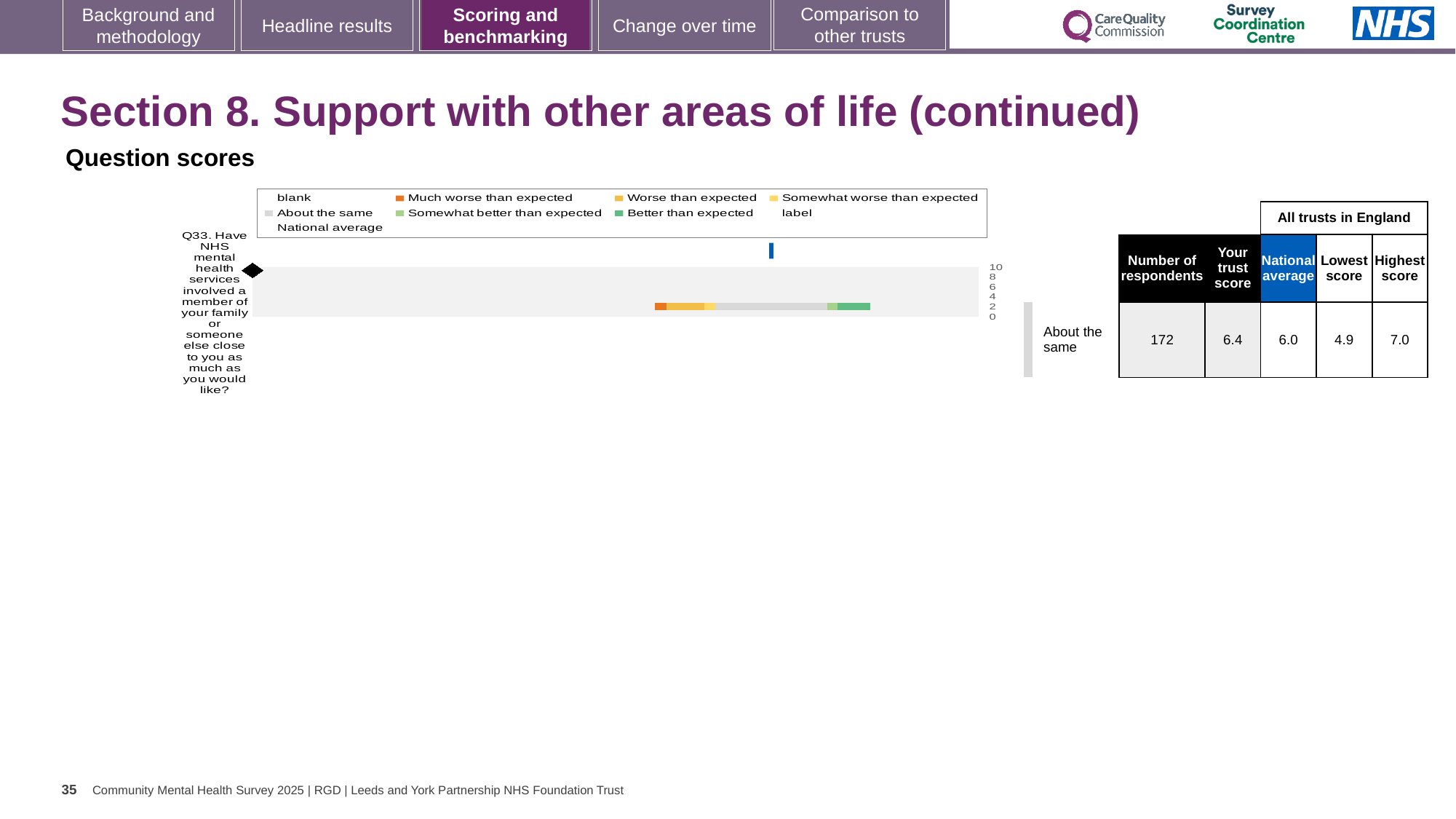
In the table beside the chart, what is the national average for Q33? 6.0 How many questions (categories) are plotted in the chart? 1 Which question is plotted in the chart? Q33. Have NHS mental health services involved a member of your family or someone else close to you as much as you would like? In the table beside the chart, what is the lowest score among all trusts in England for Q33? 4.9 In the table beside the chart, what is the difference between the highest score and the lowest score for Q33? 2.1 What benchmark category label is shown next to the chart for Q33? About the same In the table beside the chart, which is larger for Q33: the trust score or the national average? trust score What kind of chart is shown on the slide? bar chart What is the highest value shown on the chart's axis? 10 In the table beside the chart, what is the trust's score for Q33? 6.4 What colour does the legend use for 'Much worse than expected'? orange In the table beside the chart, how many respondents answered Q33? 172